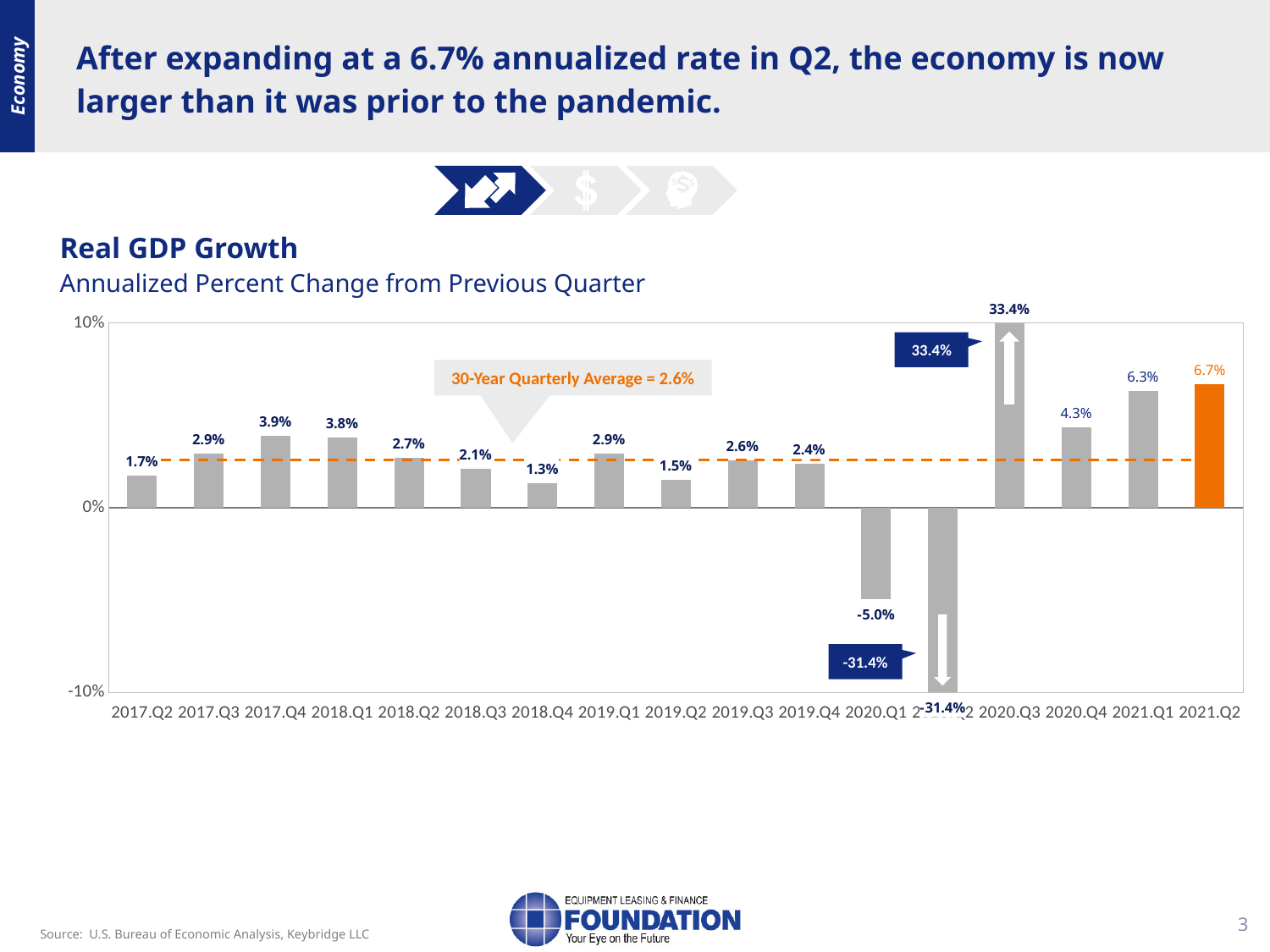
Which is larger, the Real GDP Growth value for 2017.Q4 or for 2018.Q1? 2017.Q4 What is the 30-year quarterly average shown by the dashed line in the Real GDP Growth chart? 2.6% What is the difference between the Real GDP Growth values for 2021.Q2 and 2021.Q1? 0.4% Which quarter's bar is highlighted in orange in the Real GDP Growth chart? 2021.Q2 What is the Real GDP Growth value for 2018.Q4? 1.3% Which quarter has the highest Real GDP Growth value? 2020.Q3 What is the Real GDP Growth value for 2020.Q4? 4.3% How many quarters are plotted in the Real GDP Growth chart? 17 What is the Real GDP Growth value for 2020.Q1? -5.0% What is the Real GDP Growth value for 2021.Q2? 6.7% What kind of chart is used to show Real GDP Growth? Bar chart Which quarter has the lowest Real GDP Growth value? 2020.Q2